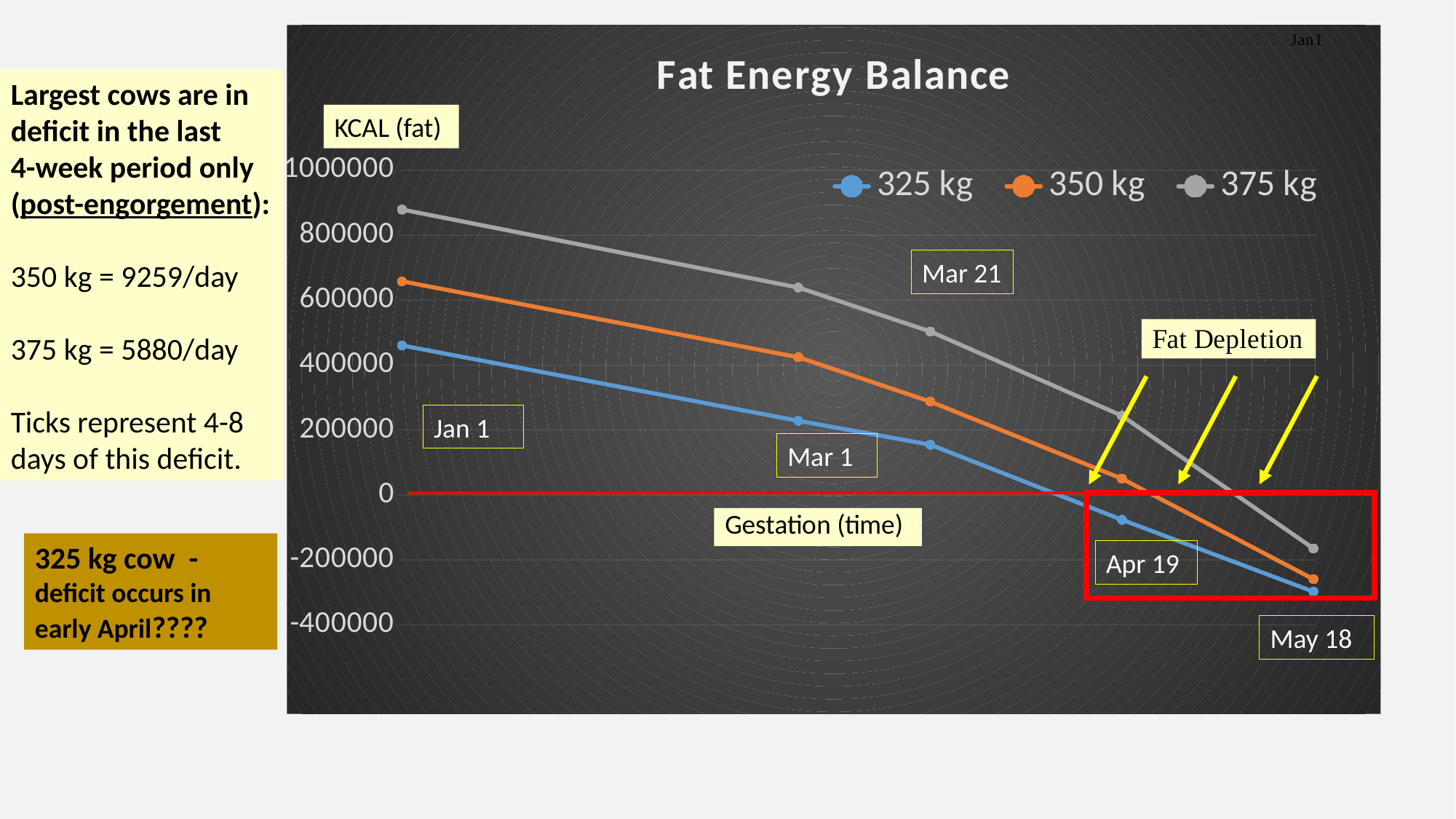
Which series has the highest value at Jan 1? 375 kg Do the values for the 350 kg series rise or fall from Jan 1 to May 18? fall Which series is plotted with the grey line? 375 kg What is the title of the chart? Fat Energy Balance Is the value for the 325 kg series at May 18 greater or less than -200000? less Which series has the lowest value at May 18? 325 kg At Mar 1, which is larger: the value for the 350 kg series or the 325 kg series? 350 kg How many series does the chart legend list? 3 Is the value for the 375 kg series at Jan 1 greater or less than 800000? greater How many data points does each series have? 5 What kind of chart is shown on the slide? line chart Is the value for the 325 kg series at Jan 1 greater or less than 400000? greater